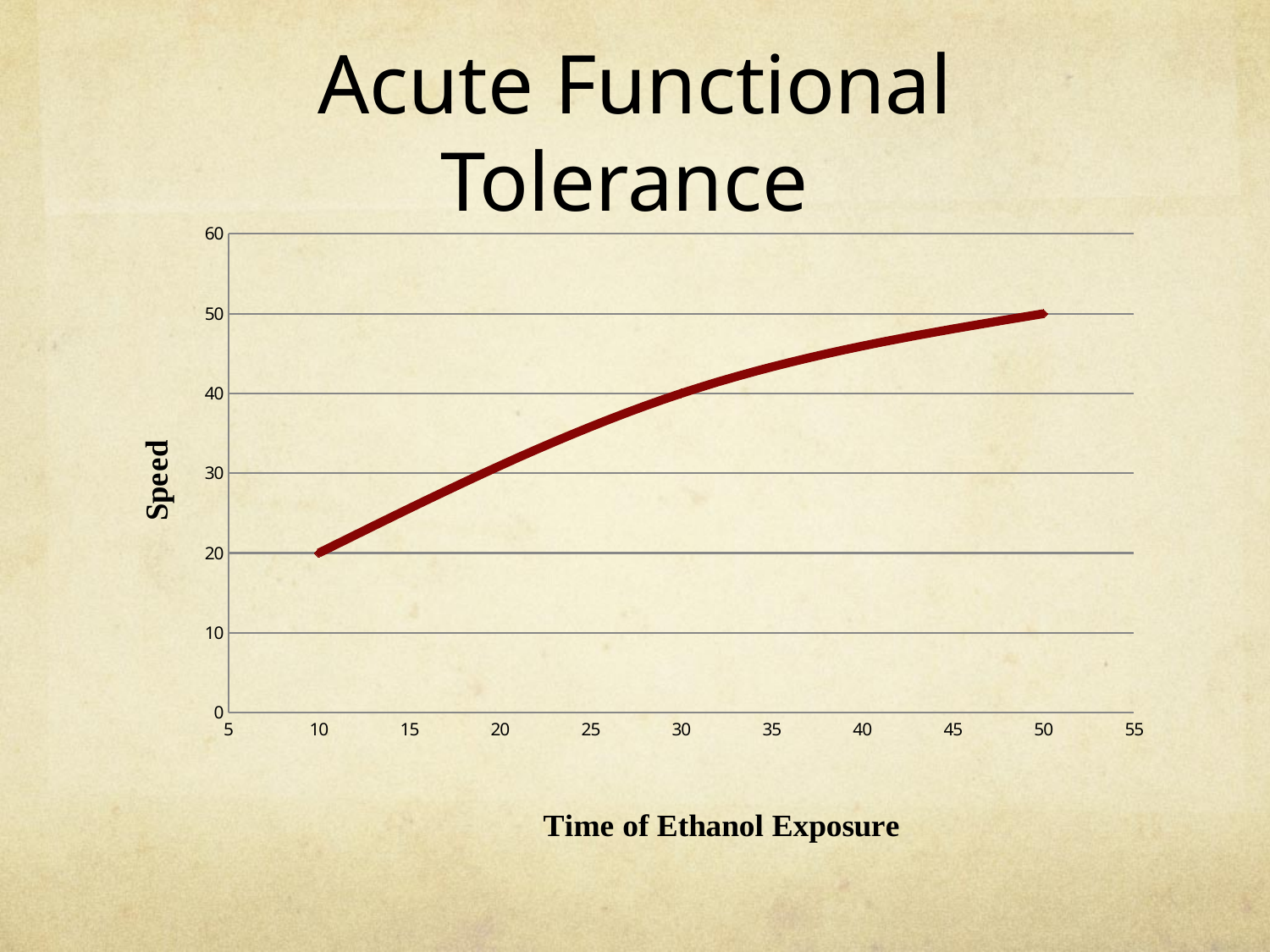
What is the label on the horizontal axis of the chart? Time of Ethanol Exposure Is the Speed value at a Time of Ethanol Exposure of 35 greater or less than 40? greater Does Speed rise or fall as Time of Ethanol Exposure increases? rises What is the Speed value at a Time of Ethanol Exposure of 10? 20 Which has the larger Speed value: Time of Ethanol Exposure 20 or 40? 40 What kind of chart is shown on the slide? line chart What is the difference in Speed between Time of Ethanol Exposure 50 and 10? 30 Is the Speed value at a Time of Ethanol Exposure of 15 greater or less than 30? less Is the Speed value at a Time of Ethanol Exposure of 40 greater or less than 40? greater At which Time of Ethanol Exposure is Speed lowest? 10 What is the Speed value at a Time of Ethanol Exposure of 50? 50 At which Time of Ethanol Exposure is Speed highest? 50